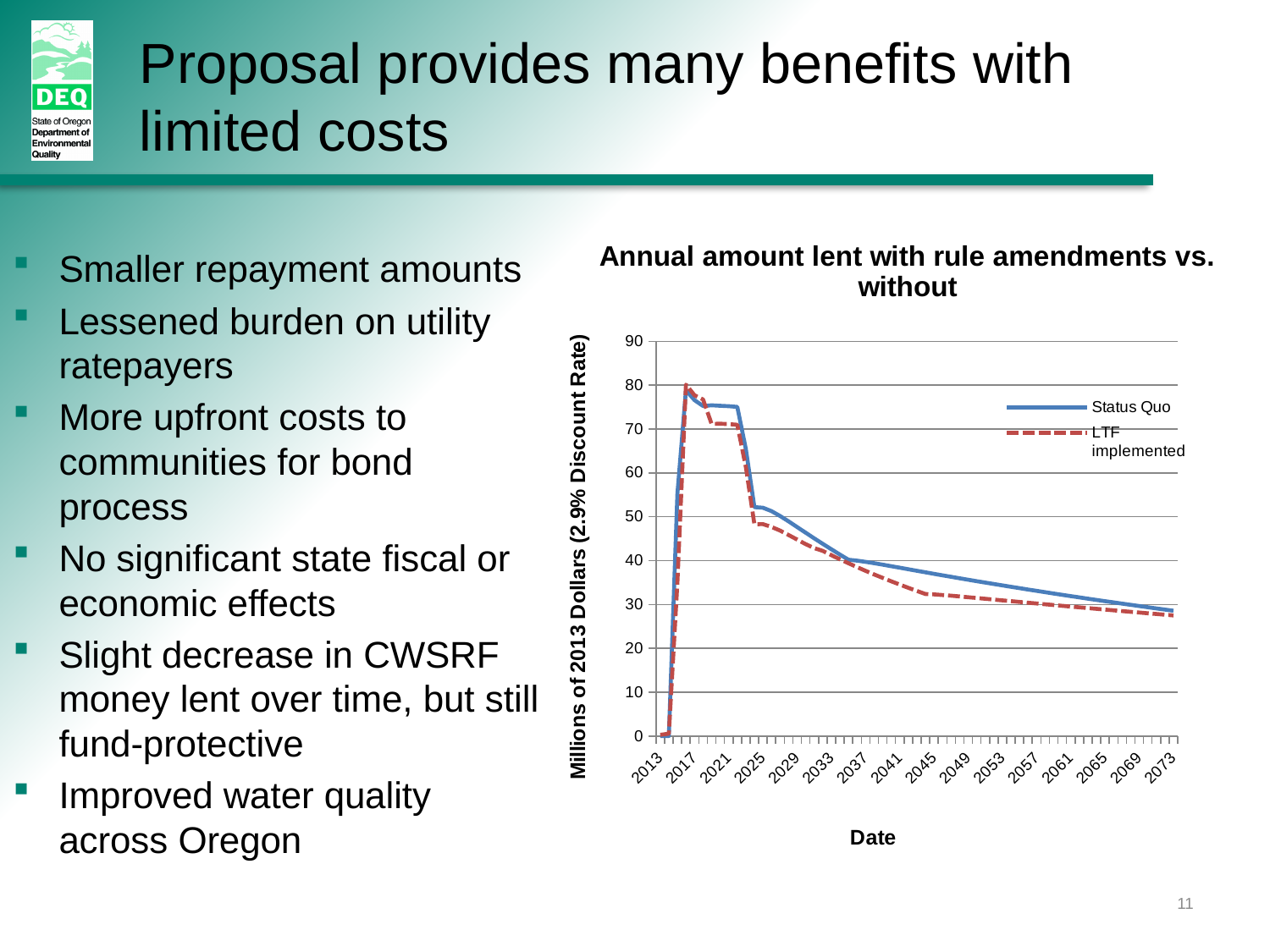
What is the title of the chart? Annual amount lent with rule amendments vs. without What kind of chart is shown on the slide? line chart Is the value for LTF implemented in 2013 greater or less than 10? less How many series does the chart's legend list? 2 Which series is drawn with a dashed line? LTF implemented Is the value for Status Quo in 2021 greater or less than 70? greater In 2045, which series has the higher value, Status Quo or LTF implemented? Status Quo After the peak around 2017, do the values for Status Quo rise or fall along the x axis? fall How many year labels are shown on the x axis? 16 Is the value for LTF implemented in 2037 greater or less than 50? less What is the label on the chart's vertical axis? Millions of 2013 Dollars (2.9% Discount Rate)